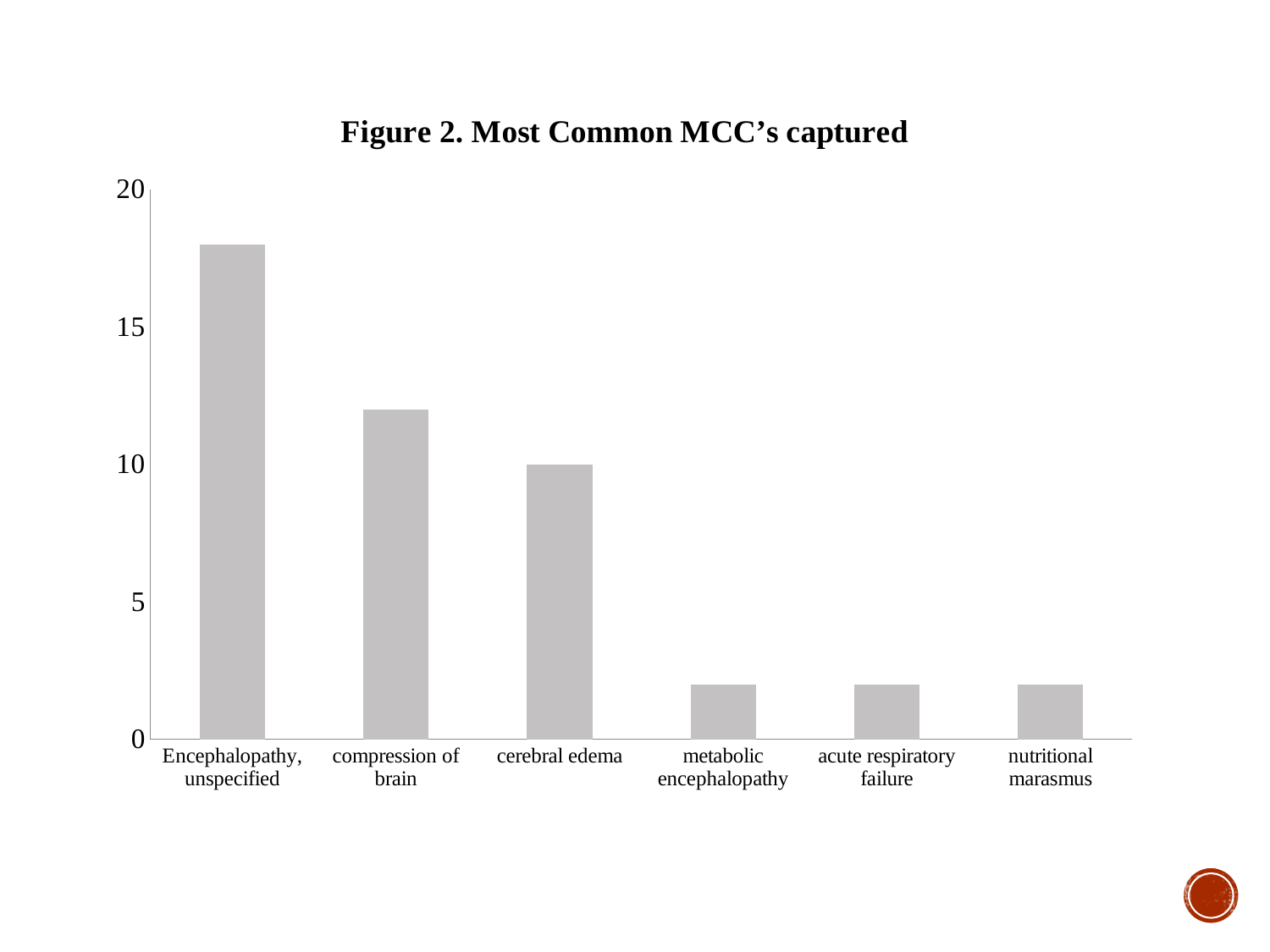
Which is larger, the value for compression of brain or the value for cerebral edema? compression of brain What is the title of the chart? Figure 2. Most Common MCC's captured Which is larger, the value for Encephalopathy, unspecified or the value for acute respiratory failure? Encephalopathy, unspecified Which category has the highest value in the chart? Encephalopathy, unspecified Is the value for compression of brain greater or less than 10? greater What kind of chart is shown on the slide? bar chart How many categories are shown on the x axis of the chart? 6 Is the value for metabolic encephalopathy greater or less than 5? less Is the value for Encephalopathy, unspecified greater or less than 15? greater Do the values generally rise or fall moving from left to right along the x axis? fall What is the value for cerebral edema? 10